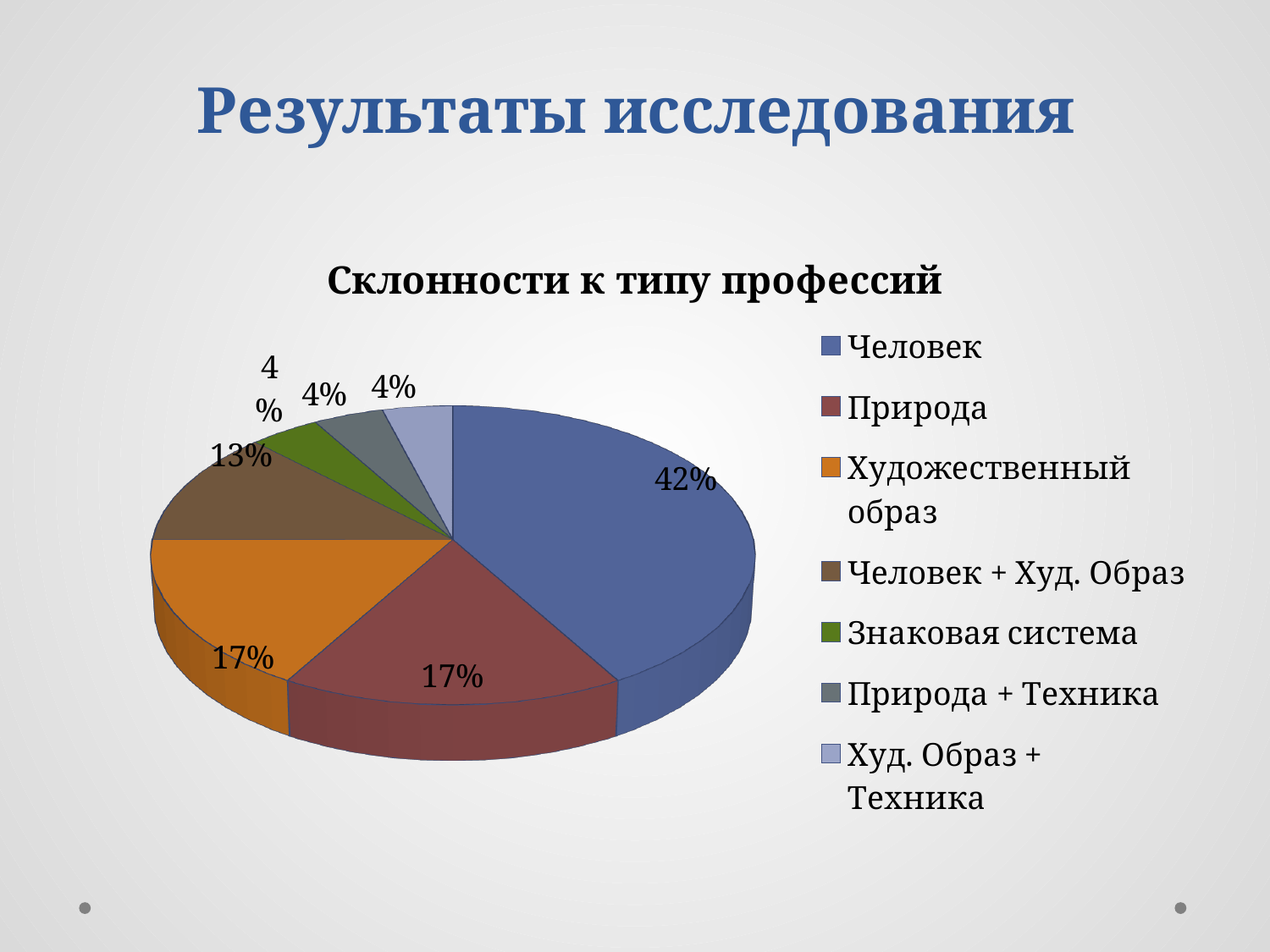
What is the title of the chart? Склонности к типу профессий What is the difference between the shares of Человек and Природа? 25% What is the value for Человек + Худ. Образ? 13% What is the value for Художественный образ? 17% Which category has the largest share of the pie? Человек Which is larger, the share for Человек + Худ. Образ or the share for Природа + Техника? Человек + Худ. Образ What is the value for Природа? 17% How many categories does the pie chart have? 7 What kind of chart is shown on the slide? pie chart Which legend entry is shown in orange? Художественный образ What share of the pie does Человек have? 42% What is the value for Знаковая система? 4%